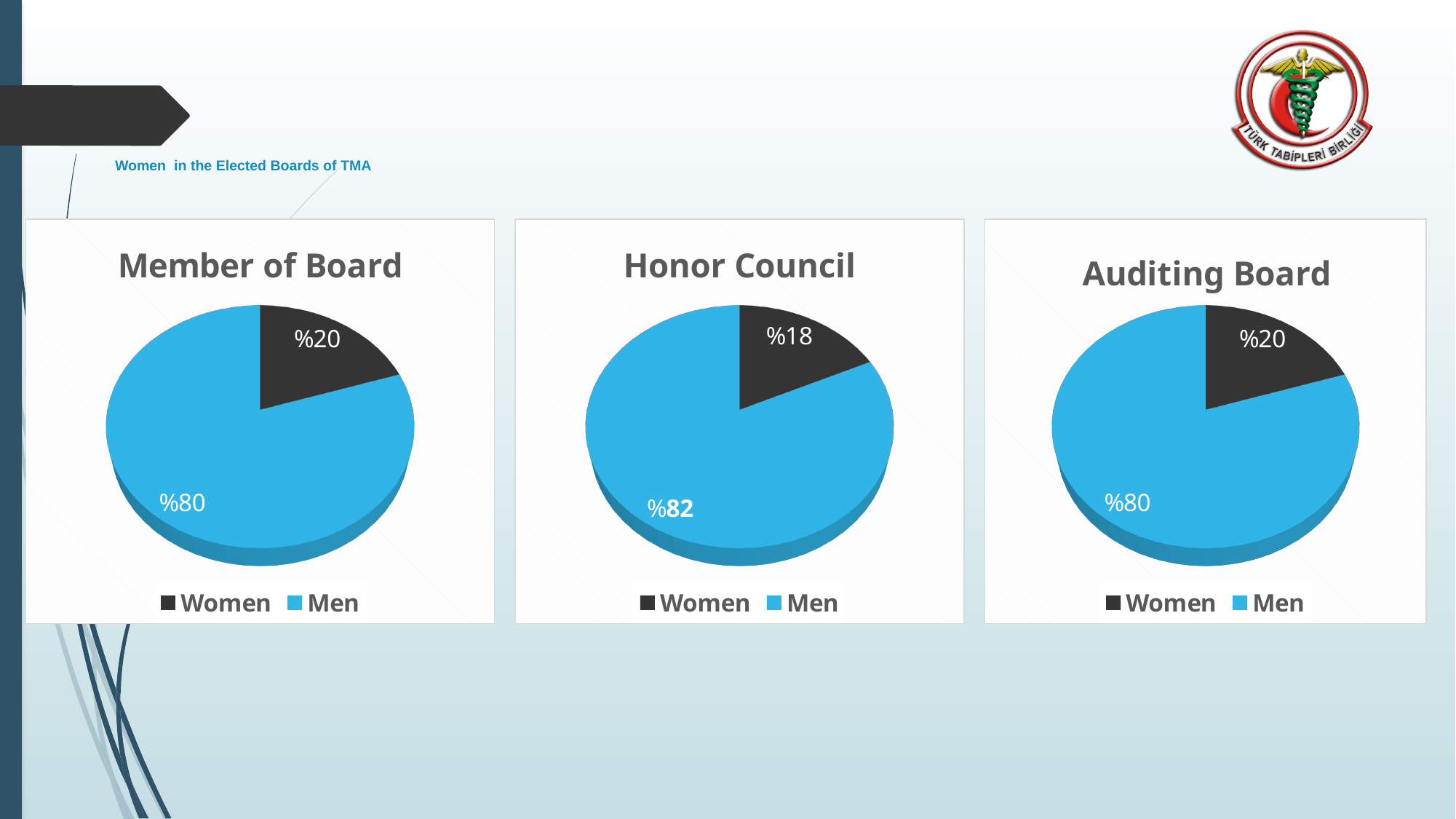
In the 'Honor Council' chart, which colour represents Women in the legend? Dark grey In the 'Honor Council' chart, what is the difference between the Men and Women shares? 64 percentage points In the 'Member of Board' chart, what share of the pie is Women? %20 In the 'Member of Board' chart, what is the difference between the Men and Women shares? 60 percentage points What kind of chart is the 'Auditing Board' chart? Pie chart In the 'Honor Council' chart, what share of the pie is Women? %18 In the 'Honor Council' chart, which slice is larger, Women or Men? Men How many slices does the 'Member of Board' pie chart have? 2 In the 'Auditing Board' chart, what share of the pie is Women? %20 In the 'Honor Council' chart, what share of the pie is Men? %82 In the 'Member of Board' chart, what share of the pie is Men? %80 In the 'Auditing Board' chart, what share of the pie is Men? %80